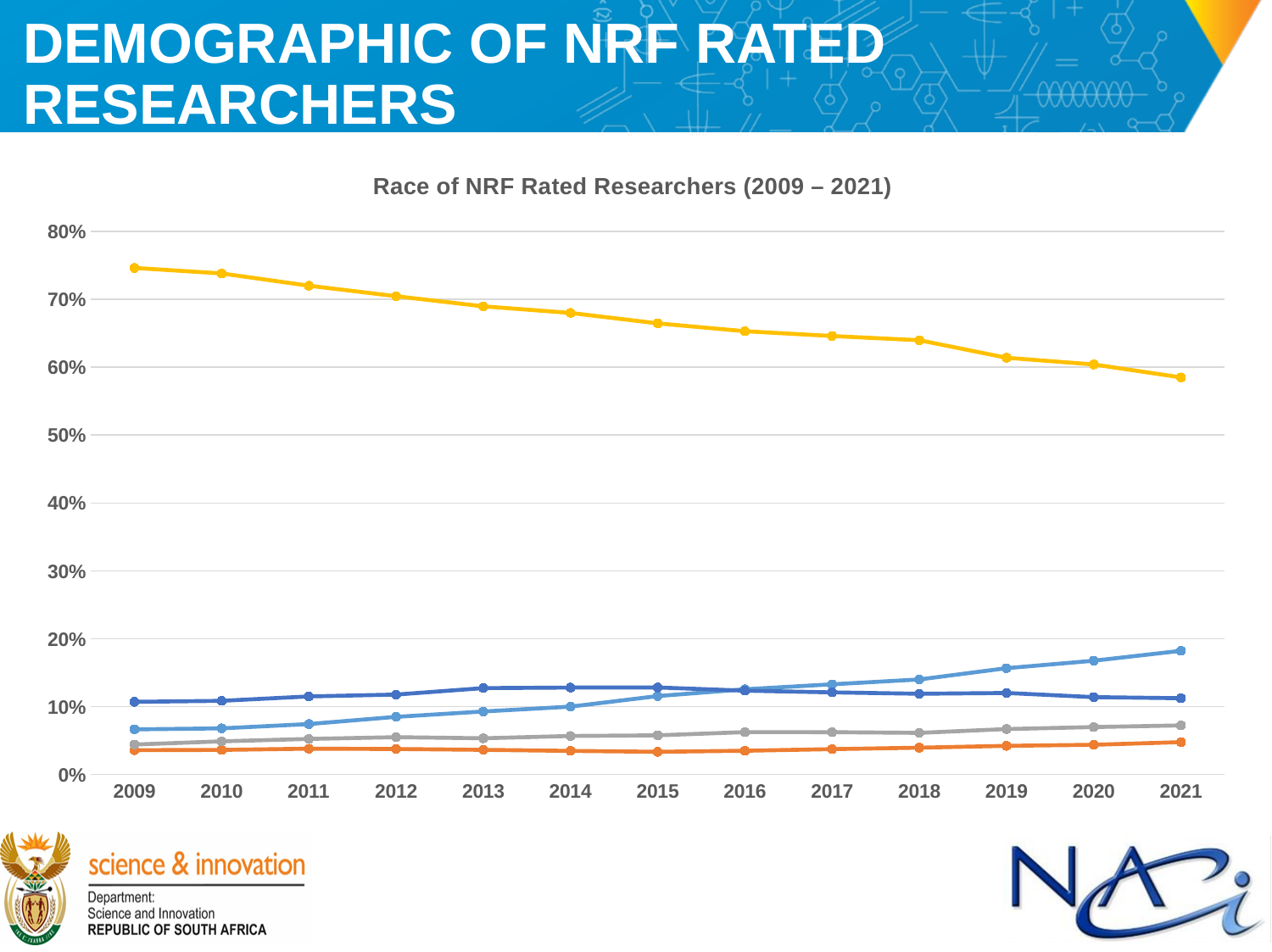
What kind of chart is shown on the slide? Line chart Is the value of the yellow line in 2021 greater or less than 60%? less Which coloured line has the highest values throughout the chart? The yellow line Is the value of the yellow line in 2009 greater or less than 70%? greater How many years are shown along the x axis of the chart? 13 Does the yellow line rise or fall from 2009 to 2021? Fall Is the value of the light blue line in 2021 greater or less than 10%? greater What is the title of the chart? Race of NRF Rated Researchers (2009 – 2021) In 2021, which is higher: the light blue line or the dark blue line? The light blue line How many lines are plotted on the chart? 5 Does the light blue line rise or fall from 2009 to 2021? Rise